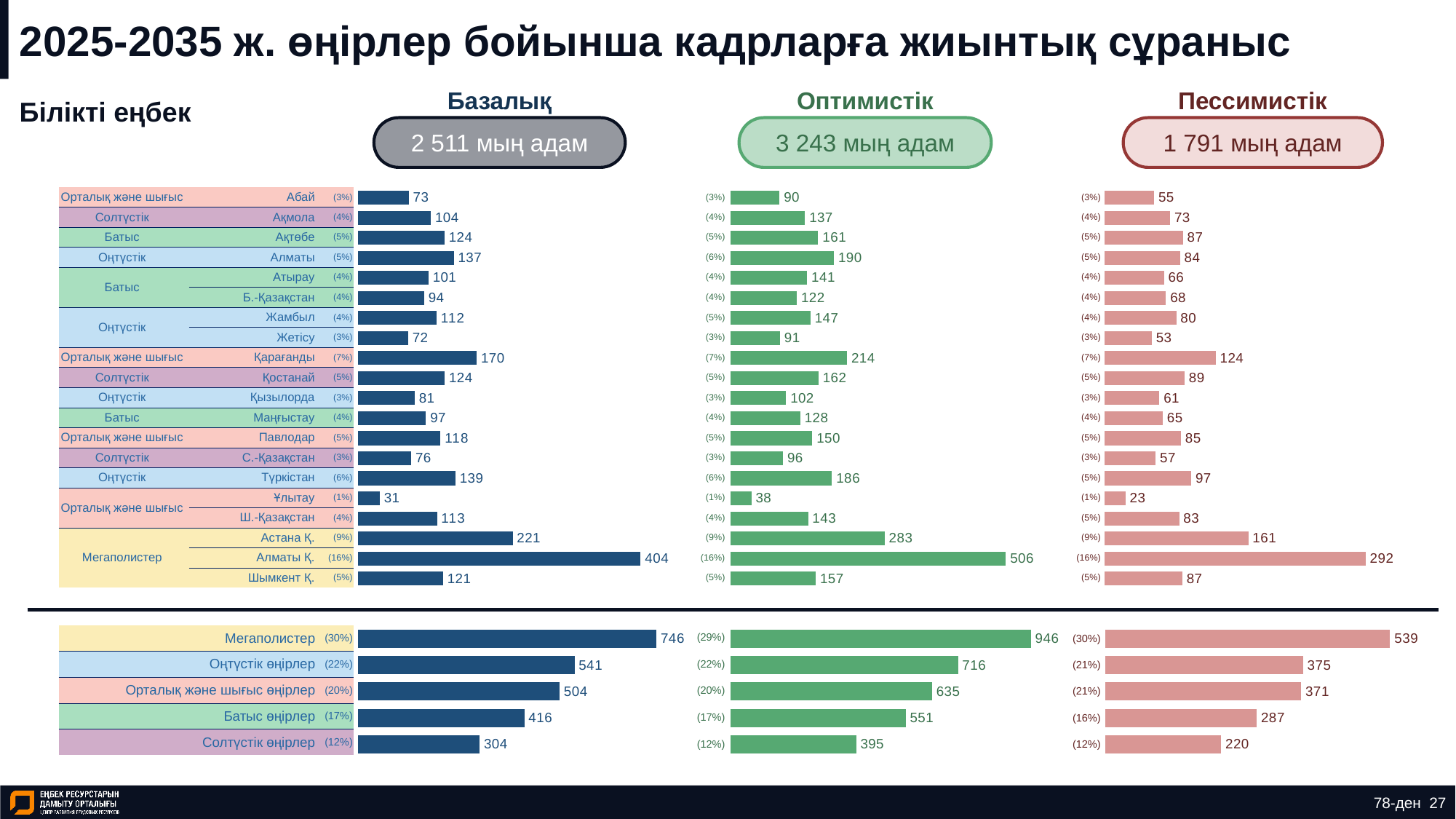
In the Базалық chart, what is the value for Қарағанды? 170 In the Оптимистік chart, what is the value for Астана Қ.? 283 In the Пессимистік chart, what is the difference between Алматы Қ. and Астана Қ.? 131 What type of chart is used on this slide? Bar chart What total is shown in the box under the Пессимистік heading? 1 791 мың адам In the Базалық chart, which is larger: Ақтөбе or Алматы? Алматы In the bottom summary of the Оптимистік chart, what is the value for Мегаполистер? 946 In the Пессимистік chart, what is the value for Түркістан? 97 In the Базалық chart, which region has the highest value? Алматы Қ. In the Оптимистік chart, which region has the lowest value? Ұлытау How many regions are listed in the top section of each scenario chart? 20 In the bottom summary of the Базалық chart, what is the difference between Оңтүстік өңірлер and Солтүстік өңірлер? 237